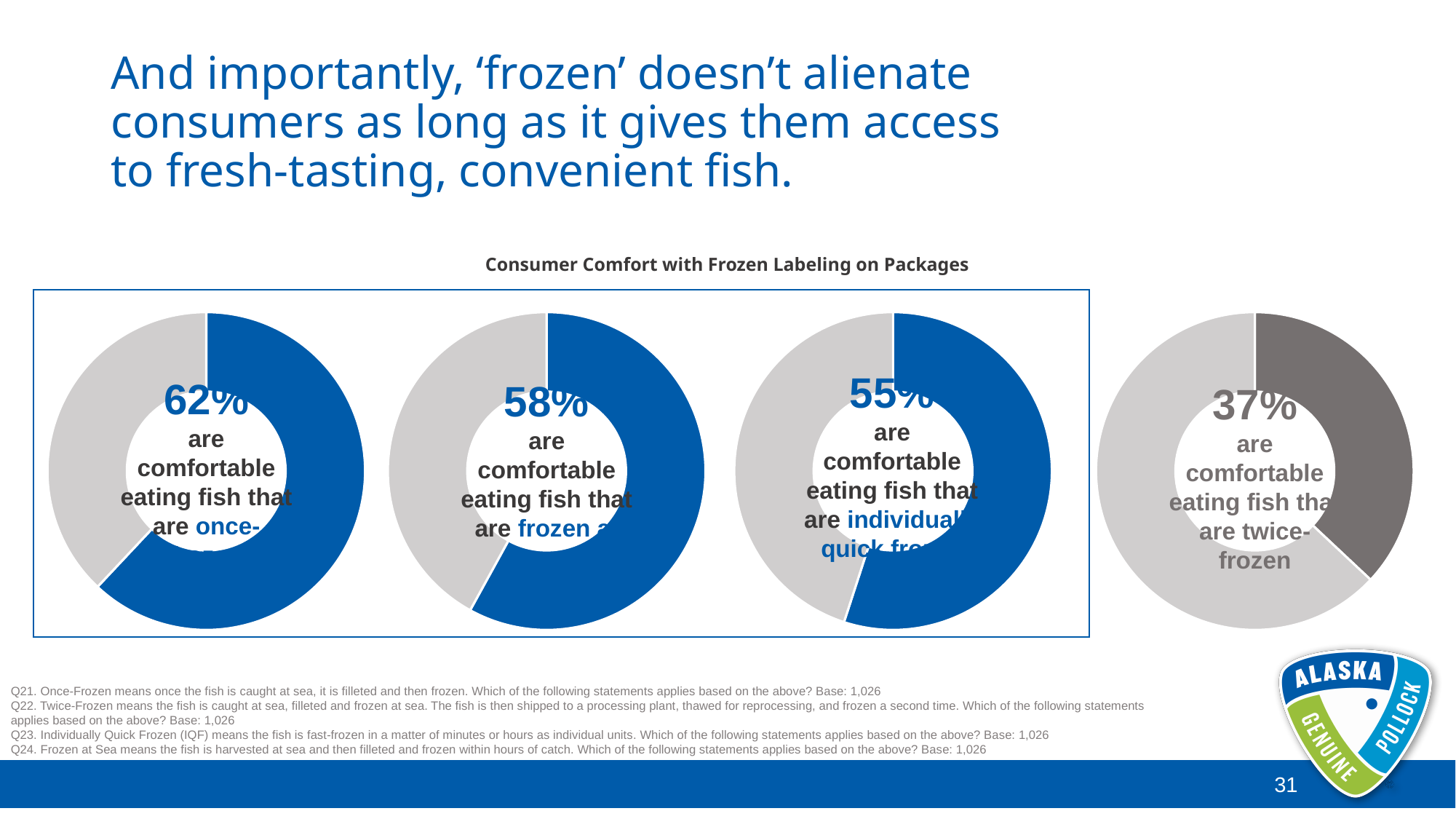
Which donut chart shows the highest percentage of comfortable consumers? The first (leftmost) chart, 62% What is the title shown above the row of donut charts? Consumer Comfort with Frozen Labeling on Packages What is the difference between the percentage in the leftmost donut chart and the percentage in the rightmost donut chart? 25 percentage points In the second donut chart from the left, what percentage is shown in the centre? 58% How many donut charts are shown on the slide? 4 In the first (leftmost) donut chart, what percentage of consumers are comfortable eating fish that are once-frozen? 62% Which donut chart shows the lowest percentage of comfortable consumers? The rightmost chart (twice-frozen), 37% In the third donut chart from the left, what percentage is shown in the centre? 55% Which is larger: the percentage in the second donut chart from the left or the percentage in the third donut chart from the left? The second chart (58%) What kind of charts are used on this slide? Donut (pie) charts In the rightmost donut chart, what percentage of consumers are comfortable eating fish that are twice-frozen? 37% What colour is the highlighted segment in the rightmost (twice-frozen) donut chart, compared with the blue used in the other three? Dark grey